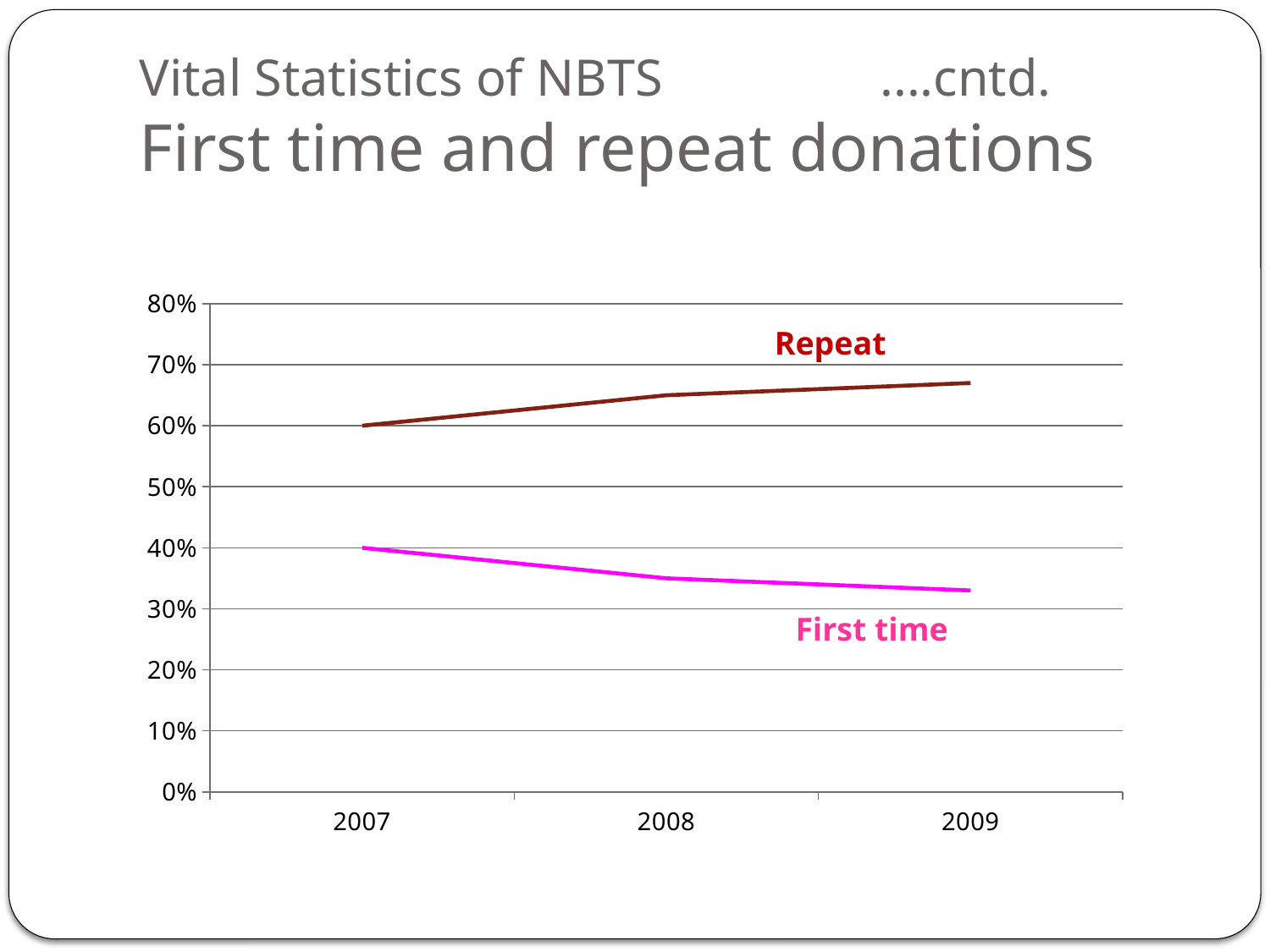
What is the difference between Repeat and First time donations in 2007? 20% How many years are shown on the x axis of the chart? 3 Does the First time line rise or fall from 2007 to 2009? fall What is the value for Repeat donations in 2007? 60% Is the value for Repeat donations in 2009 greater or less than 60%? greater Is the value for Repeat donations in 2009 greater or less than 70%? less Is the value for First time donations in 2009 greater or less than 40%? less How many series are plotted on the chart? 2 What is the value for First time donations in 2007? 40% What kind of chart is shown on the slide? line chart In 2009, which series has the larger value, Repeat or First time? Repeat Does the Repeat line rise or fall from 2007 to 2009? rise